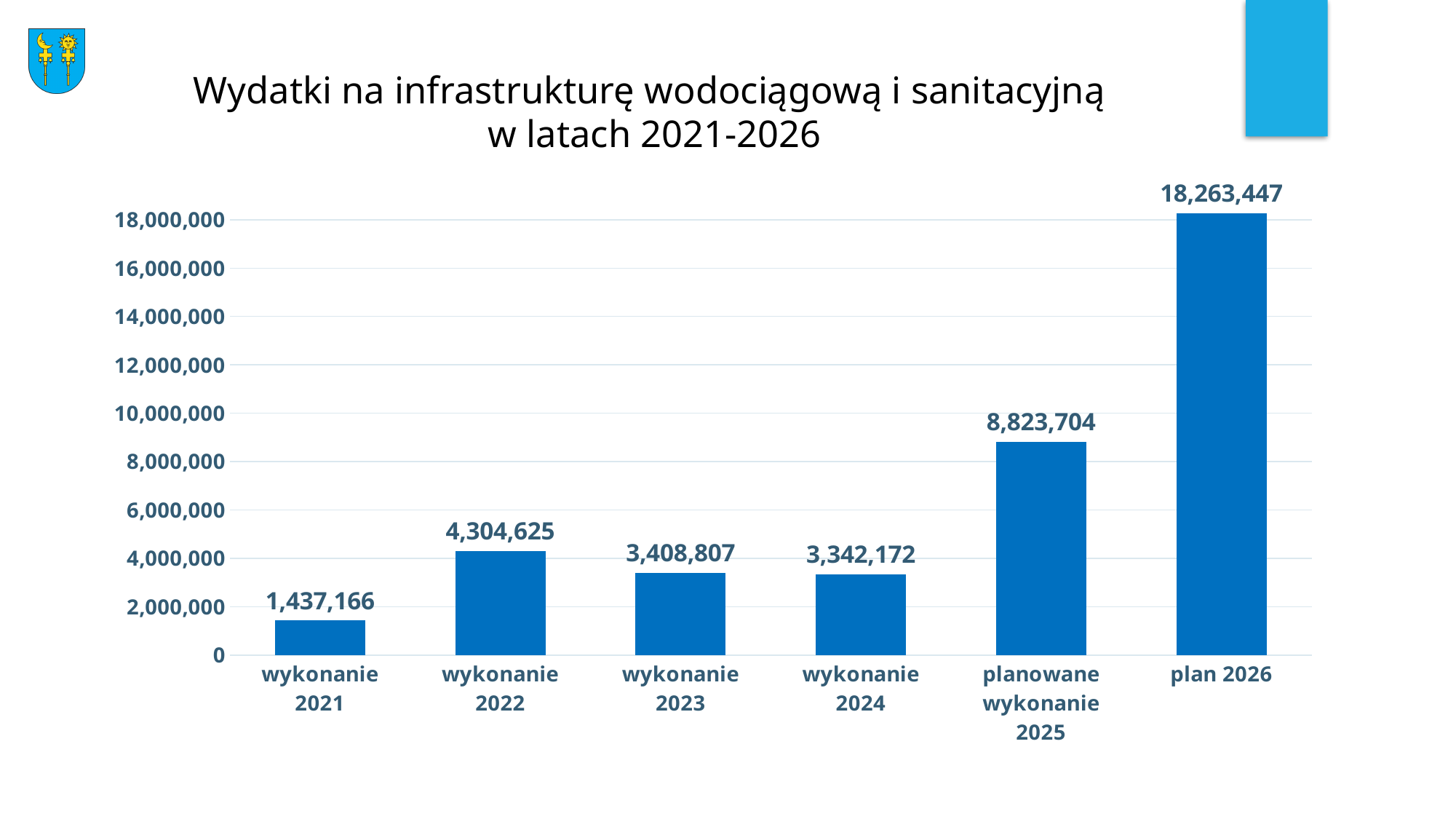
What is the value for planowane wykonanie 2025? 8,823,704 Which is larger, wykonanie 2022 or wykonanie 2024? wykonanie 2022 Which category has the lowest value? wykonanie 2021 What is the value for wykonanie 2023? 3,408,807 How many categories are shown on the x axis? 6 What is the difference between wykonanie 2022 and wykonanie 2021? 2,867,459 What is the value for plan 2026? 18,263,447 What is the difference between plan 2026 and planowane wykonanie 2025? 9,439,743 Is the value for planowane wykonanie 2025 greater or less than 8,000,000? greater What is the value for wykonanie 2021? 1,437,166 What kind of chart is shown on the slide? bar chart Which category has the highest value? plan 2026